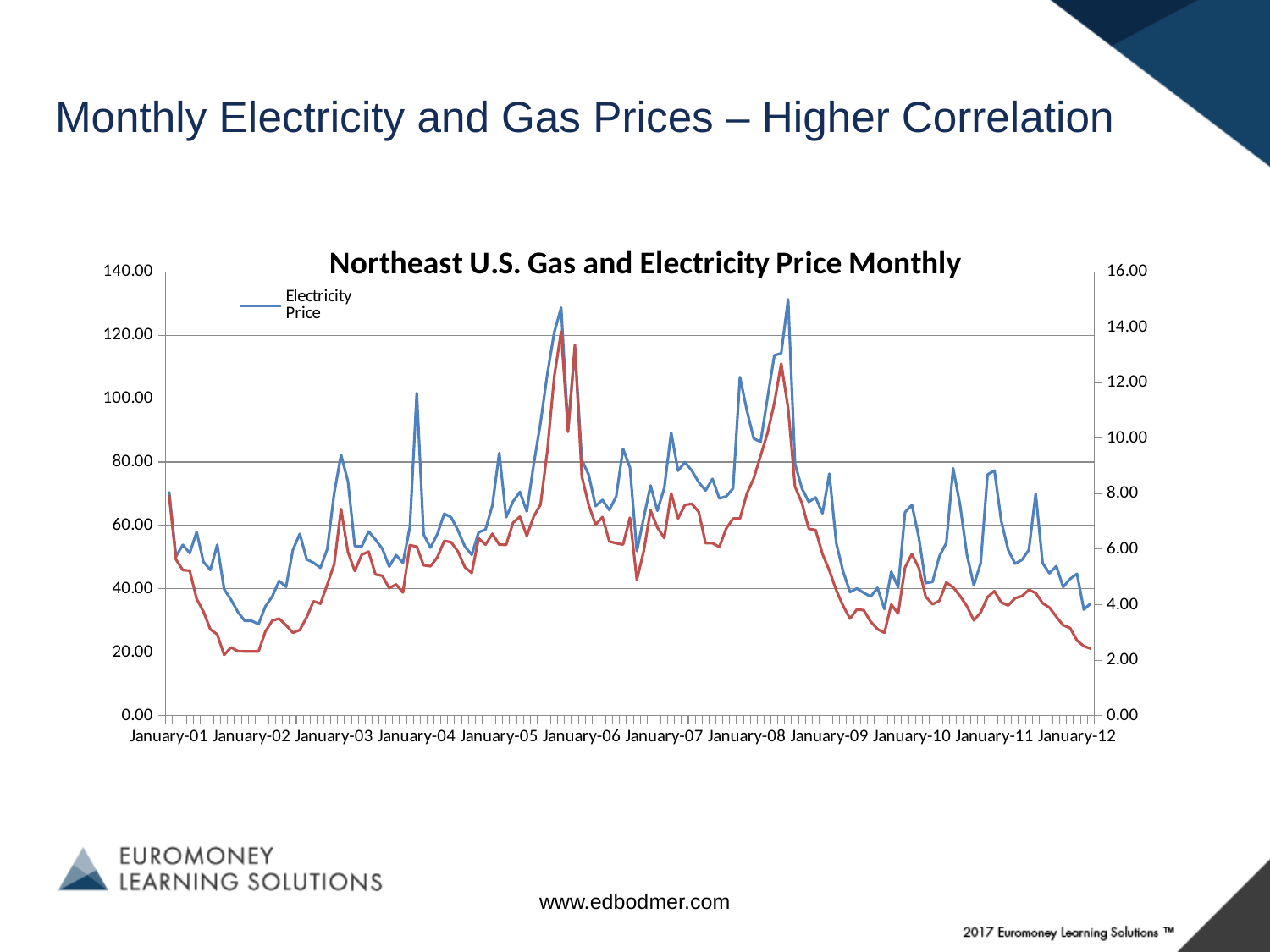
How many date labels are shown along the x axis? 12 From January-01 to January-02, does the Electricity Price rise or fall overall? fall Is the Electricity Price at January-01 greater or less than 60? greater What is the highest value shown on the right-hand vertical axis? 16.00 Is the highest peak of the Electricity Price line greater or less than 120? greater What is the title of the chart? Northeast U.S. Gas and Electricity Price Monthly Is the Electricity Price at January-04 greater or less than 40? greater What kind of chart is shown on the slide? line chart Which is larger, the Electricity Price at January-01 or at January-12? January-01